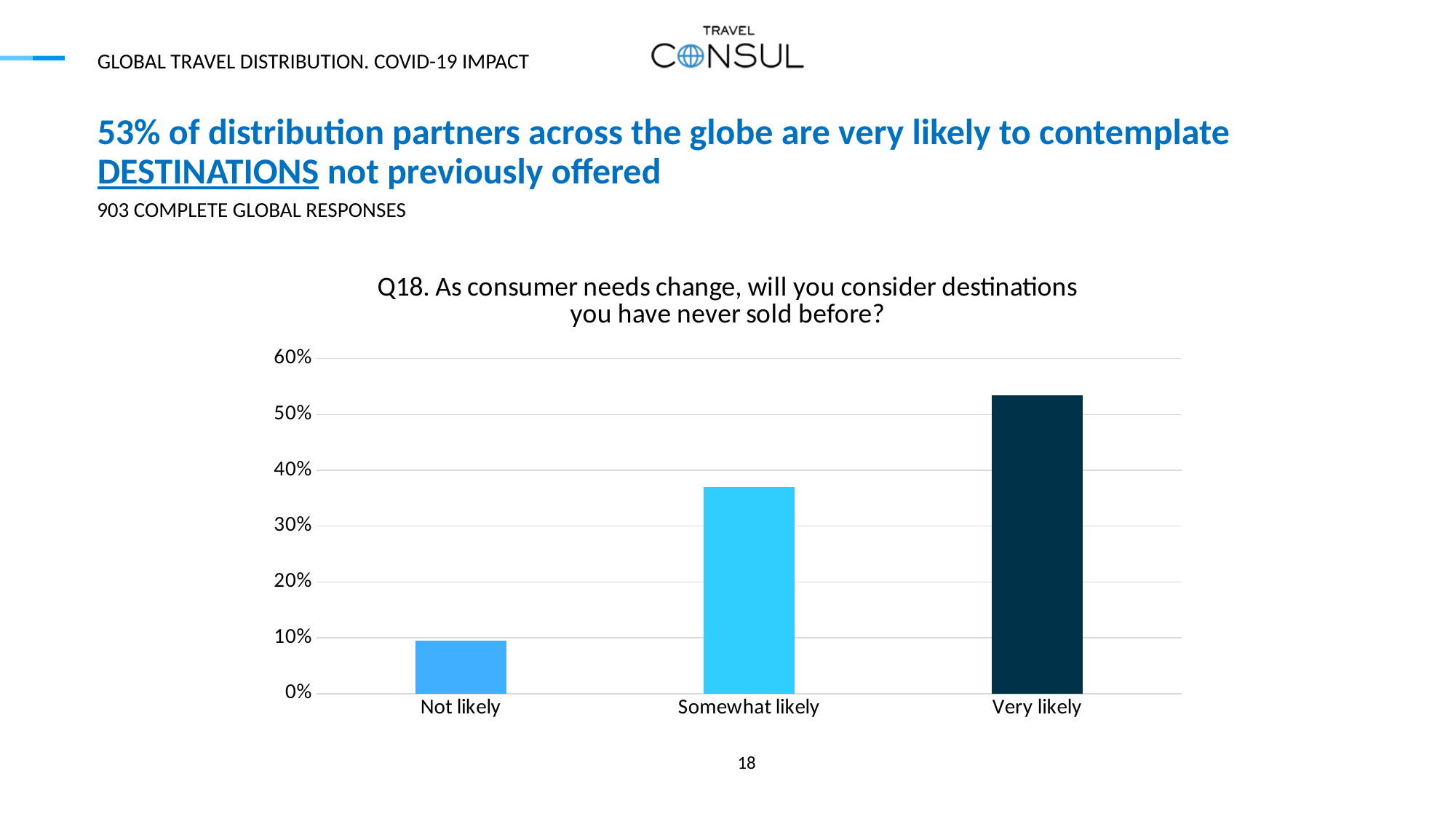
How many categories are shown on the x axis of the chart? 3 Is the value for Somewhat likely greater or less than 40%? less Is the value for Very likely greater or less than 50%? greater Which category has the highest value in the chart? Very likely Which is larger, the value for Somewhat likely or the value for Not likely? Somewhat likely What is the title of the chart? Q18. As consumer needs change, will you consider destinations you have never sold before? According to the slide headline, what share of distribution partners are very likely to consider destinations not previously offered? 53% What kind of chart is shown on the slide? bar chart Is the value for Not likely greater or less than 20%? less Which category has the lowest value in the chart? Not likely Do the values rise or fall moving from Not likely to Very likely along the x axis? rise